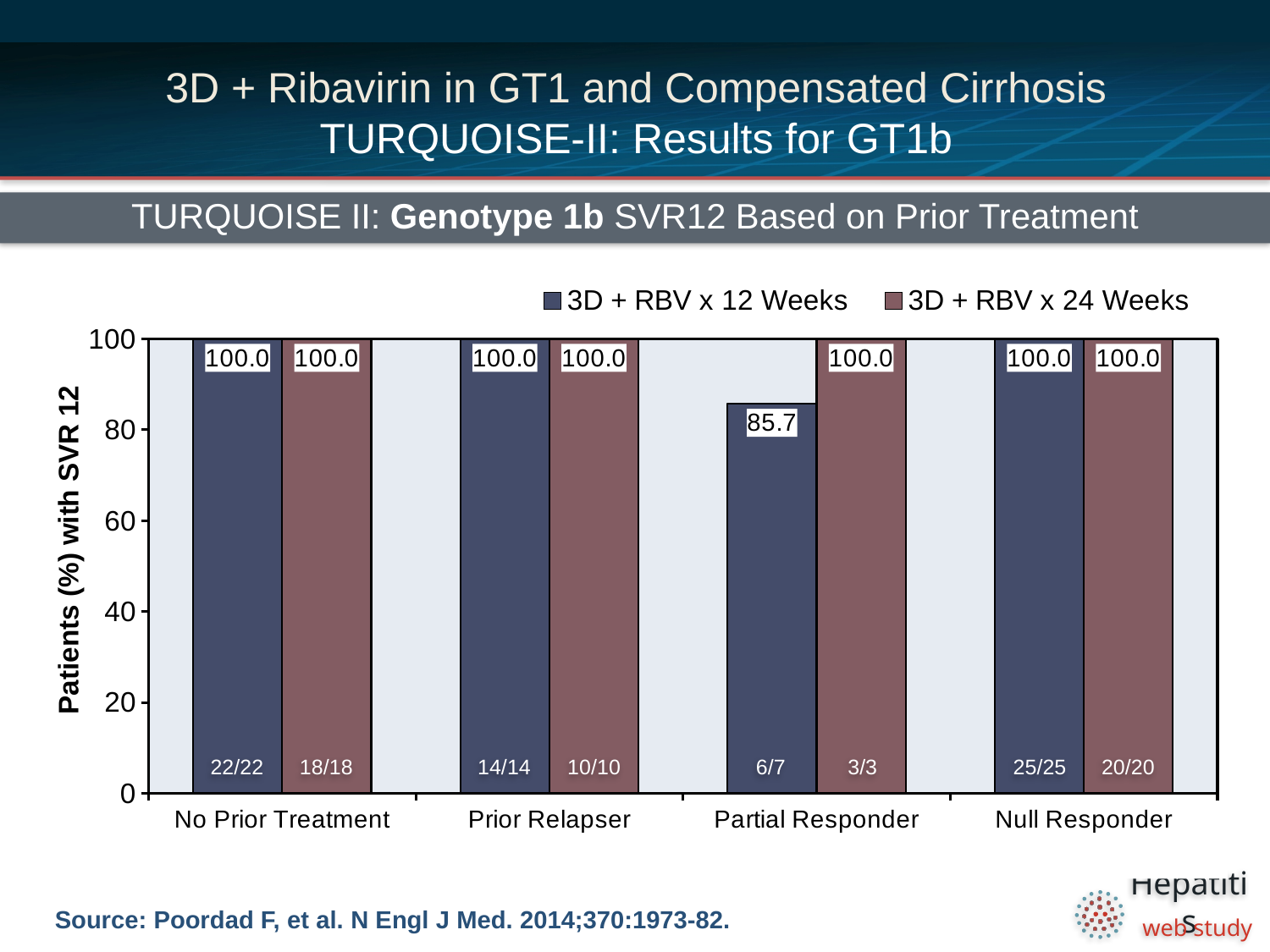
What is the label of the y axis? Patients (%) with SVR 12 For Partial Responder, which regimen has the higher SVR12 rate, 3D + RBV x 12 Weeks or 3D + RBV x 24 Weeks? 3D + RBV x 24 Weeks What is the SVR12 rate for Partial Responder patients treated with 3D + RBV x 12 Weeks? 85.7 How many series does the legend list? 2 What is the difference between the 3D + RBV x 24 Weeks and 3D + RBV x 12 Weeks SVR12 rates for Partial Responder? 14.3 Is the SVR12 rate for Partial Responder with 3D + RBV x 12 Weeks greater or less than 80? greater Which prior-treatment category has the lowest SVR12 rate for 3D + RBV x 12 Weeks? Partial Responder How many prior-treatment categories are shown on the x axis? 4 What fraction is shown at the base of the 3D + RBV x 24 Weeks bar for Prior Relapser? 10/10 How many patients achieved SVR12 in the No Prior Treatment group treated with 3D + RBV x 12 Weeks, as shown by the fraction at the base of the bar? 22/22 What is the SVR12 rate for Null Responder patients treated with 3D + RBV x 24 Weeks? 100.0 What type of chart is shown on the slide? Bar chart